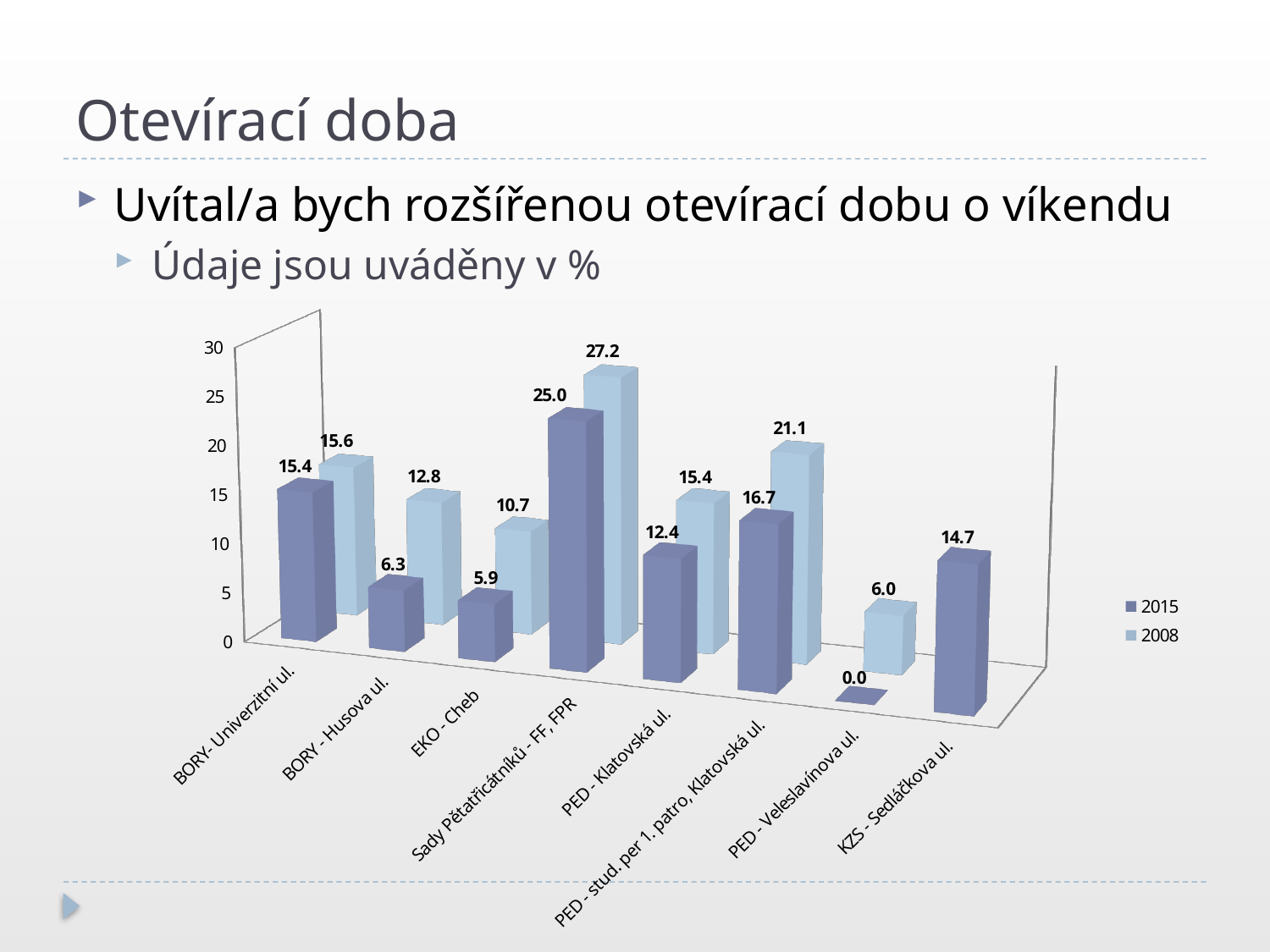
How many categories are shown on the x axis? 8 Which category has the highest 2008 value? Sady Pětatřicátníků - FF, FPR Which is larger for EKO - Cheb, the 2015 value or the 2008 value? 2008 What kind of chart is shown on the slide? bar chart What is the 2015 value for KZS - Sedláčkova ul.? 14.7 How many series does the legend list? 2 What is the 2015 value for Sady Pětatřicátníků - FF, FPR? 25.0 Which category has the lowest 2015 value? PED - Veleslavínova ul. What is the 2008 value for PED - stud. per 1. patro, Klatovská ul.? 21.1 What is the difference between the 2008 and 2015 values for BORY - Husova ul.? 6.5 What is the 2015 value for PED - Veleslavínova ul.? 0.0 Which series is shown in the lighter blue colour? 2008